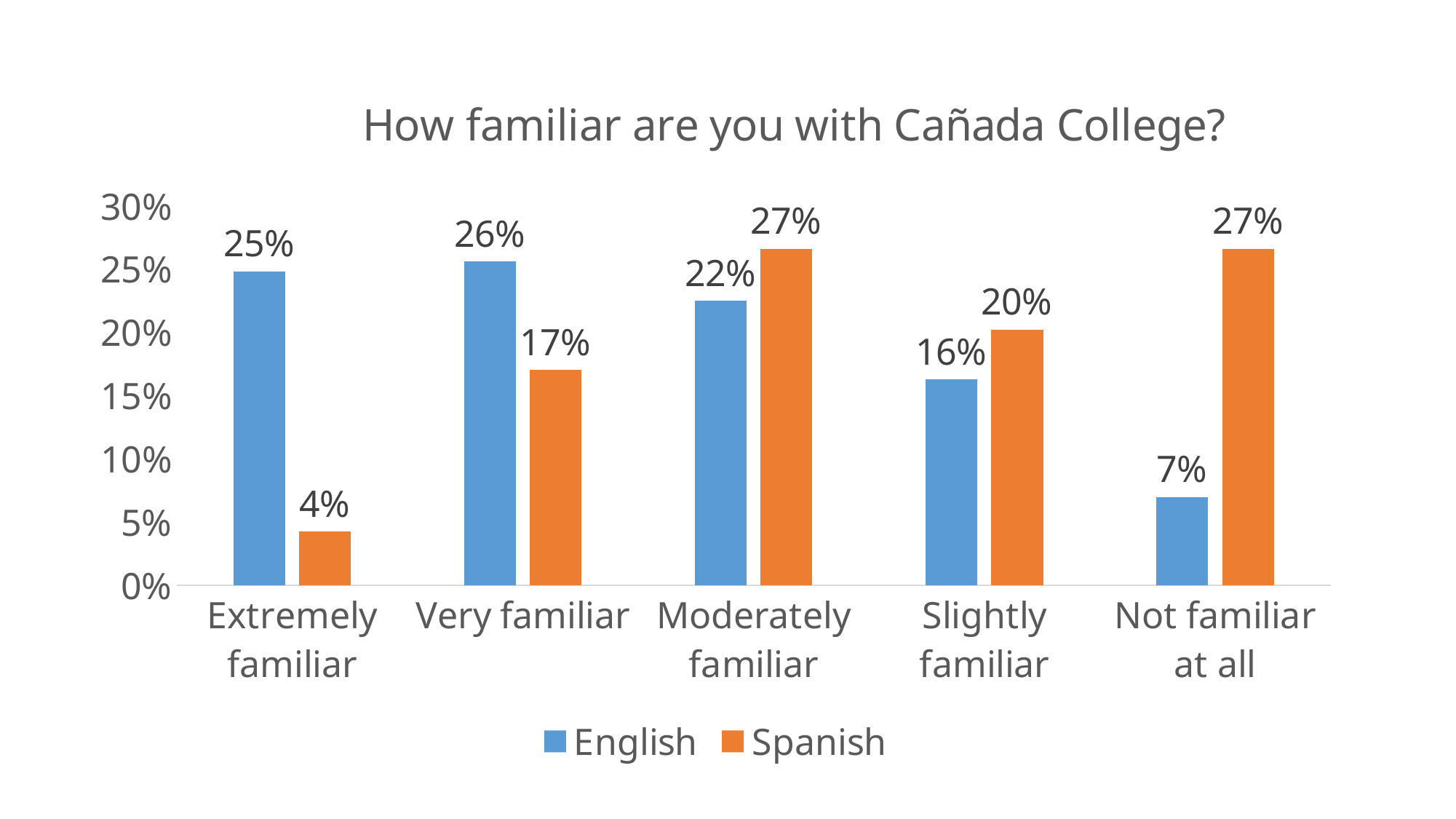
What percentage of English respondents are extremely familiar with Cañada College? 25% How many series does the legend list? 2 What kind of chart is shown on the slide? Bar chart What is the difference between the Spanish and English values for 'Not familiar at all'? 20% Which category has the lowest value for the English series? Not familiar at all Which category has the lowest value for the Spanish series? Extremely familiar What is the Spanish value for the 'Very familiar' category? 17% For 'Moderately familiar', which series has the larger value, English or Spanish? Spanish What is the difference between the English and Spanish values for 'Extremely familiar'? 21% How many categories are shown on the x axis? 5 What percentage of Spanish respondents are not familiar at all with Cañada College? 27% For 'Slightly familiar', which series has the larger value, English or Spanish? Spanish